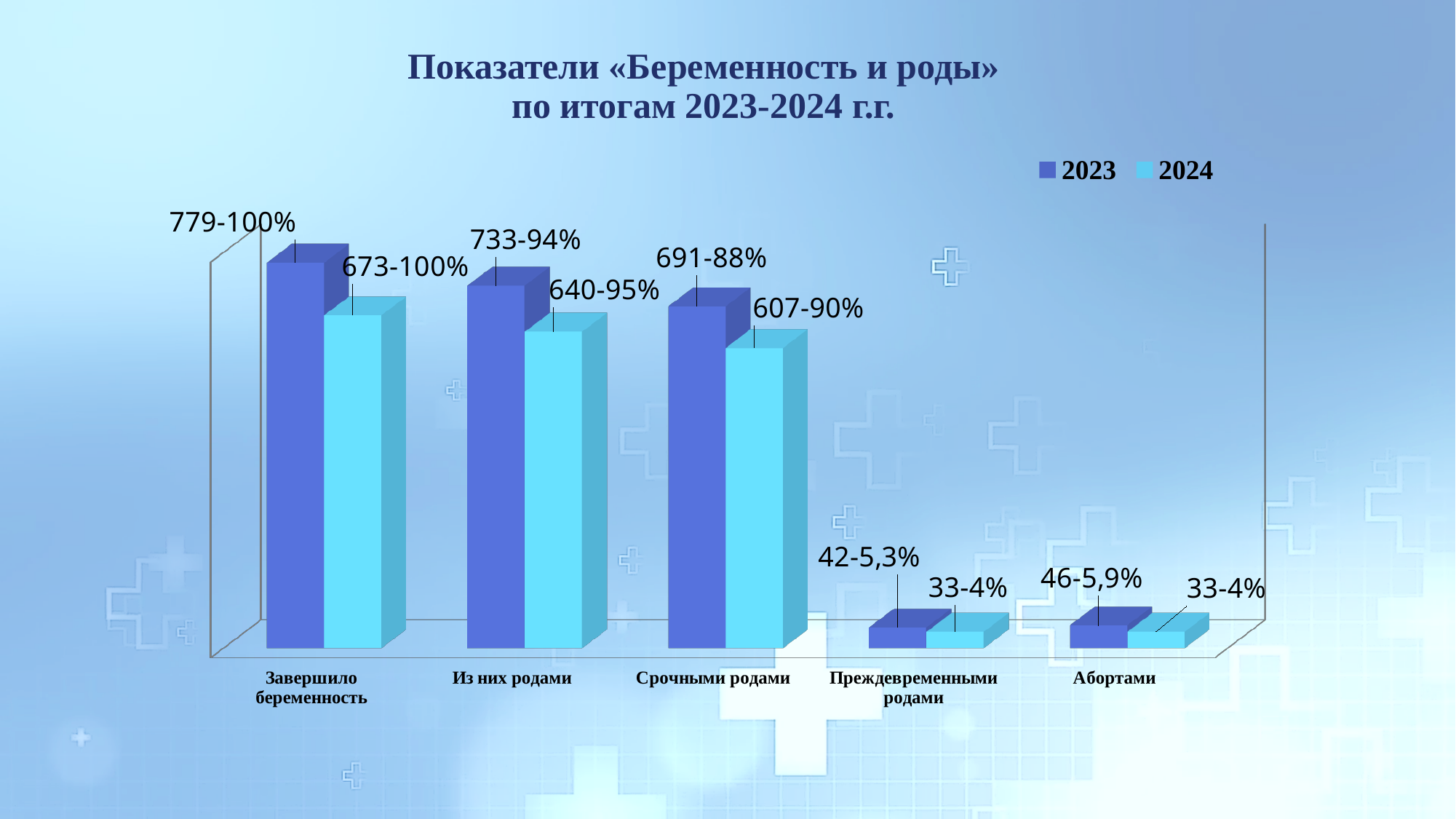
What is the data label for 2023 in the "Срочными родами" category? 691-88% How many categories are shown on the x axis? 5 Which is larger: the 2023 value for "Из них родами" or the 2024 value for "Из них родами"? 2023 What is the data label for 2024 in the "Из них родами" category? 640-95% How many series does the legend list? 2 What is the data label for 2024 in the "Преждевременными родами" category? 33-4% What is the data label for 2024 in the "Завершило беременность" category? 673-100% Which category has the highest value for the 2023 series? Завершило беременность What is the data label for 2023 in the "Абортами" category? 46-5,9% What is the difference between the 2023 and 2024 counts in the "Завершило беременность" category (779 vs 673)? 106 What is the data label for 2023 in the "Завершило беременность" category? 779-100% Which category has the lowest value for the 2024 series? Преждевременными родами and Абортами (both 33)